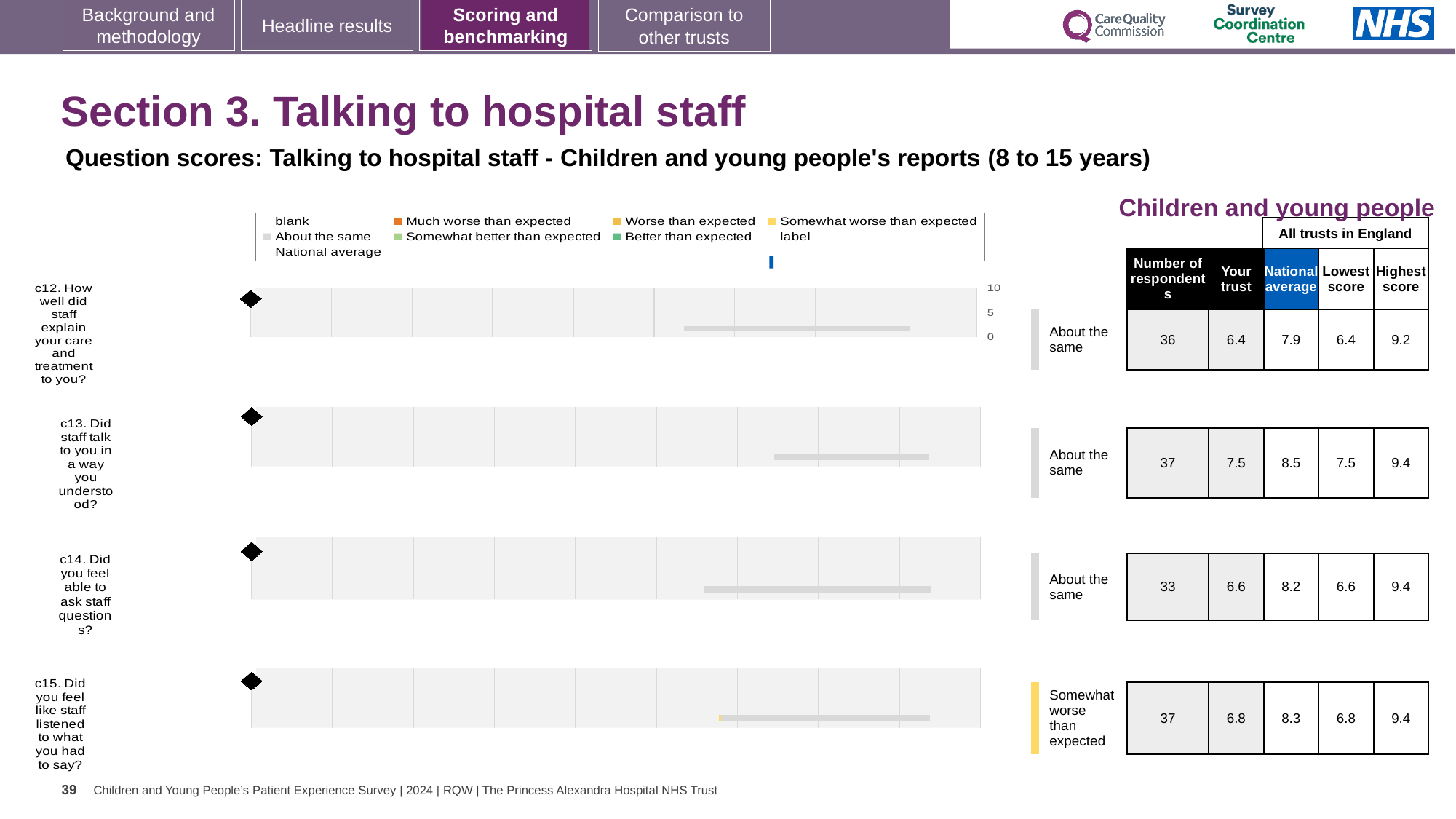
What is the 'Your trust' score for c12 (How well did staff explain your care and treatment to you?)? 6.4 What is the national average score for c13 (Did staff talk to you in a way you understood?)? 8.5 Which has the larger 'Your trust' score, c12 or c14? c14 How many respondents answered c14 (Did you feel able to ask staff questions?)? 33 Which question has the lowest 'Your trust' score? c12 What kind of chart is used for each question on the slide? Bar chart What benchmark category is shown for c15 (Did you feel like staff listened to what you had to say?)? Somewhat worse than expected What is the highest score across all trusts in England for c12? 9.2 What is the difference between the national average and the 'Your trust' score for c15? 1.5 What is the lowest score across all trusts in England for c13? 7.5 How many questions are plotted on the slide? 4 Which question has the highest 'Your trust' score? c13